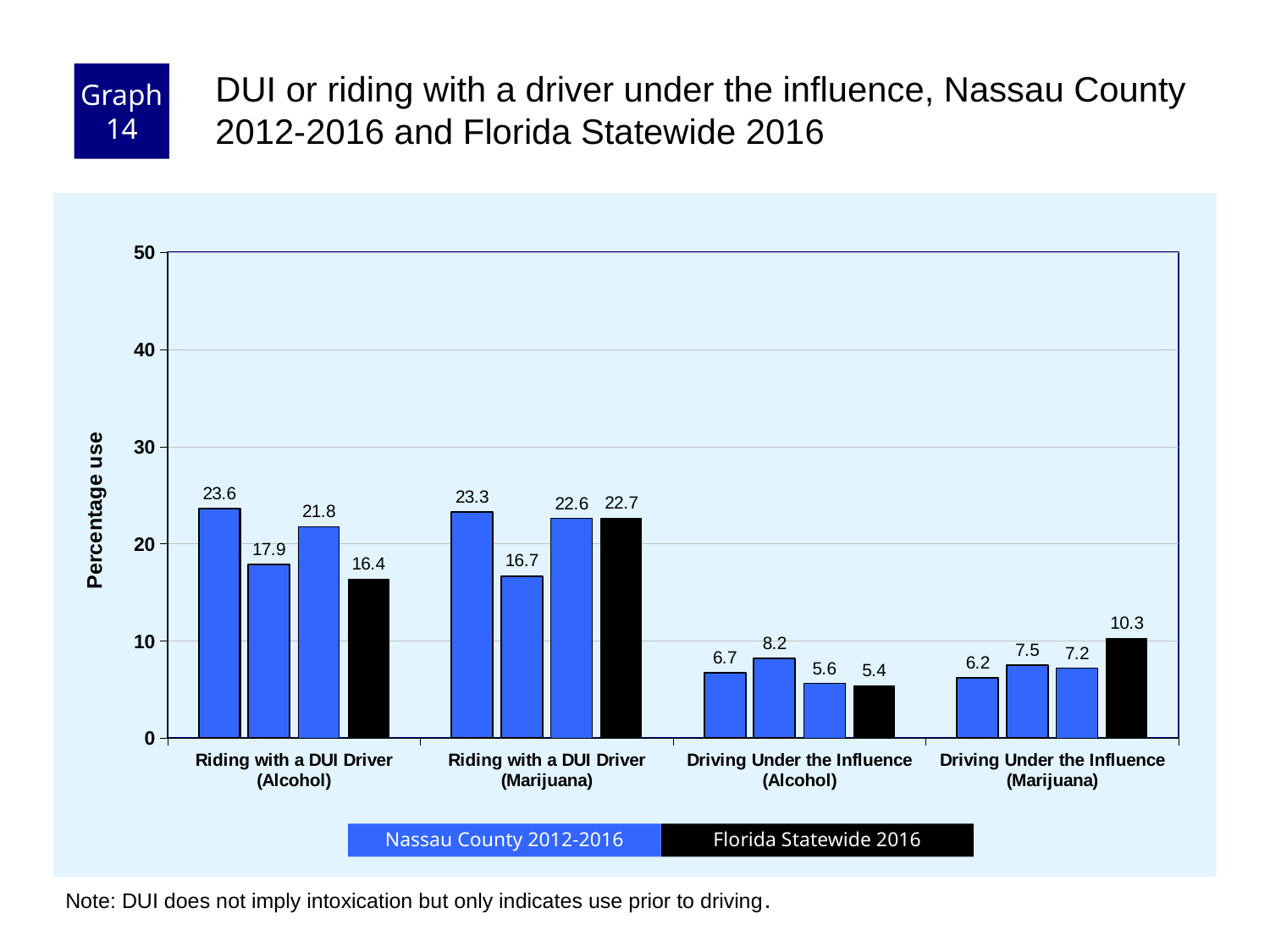
What is the difference between the Florida Statewide 2016 values for Riding with a DUI Driver (Marijuana) and Riding with a DUI Driver (Alcohol)? 6.3 How many series does the legend list? 2 For which category is the Florida Statewide 2016 value lowest? Driving Under the Influence (Alcohol) Which has the larger Florida Statewide 2016 value: Driving Under the Influence (Alcohol) or Driving Under the Influence (Marijuana)? Driving Under the Influence (Marijuana) For which category is the Florida Statewide 2016 value highest? Riding with a DUI Driver (Marijuana) What is the label of the y axis? Percentage use What is the value of the tallest Nassau County 2012-2016 bar in the Riding with a DUI Driver (Alcohol) group? 23.6 What kind of chart is shown on the slide? bar chart How many categories are shown on the x axis? 4 Is the Florida Statewide 2016 value for Riding with a DUI Driver (Alcohol) greater or less than 20? less What is the Florida Statewide 2016 value for Riding with a DUI Driver (Alcohol)? 16.4 What is the Florida Statewide 2016 value for Driving Under the Influence (Marijuana)? 10.3